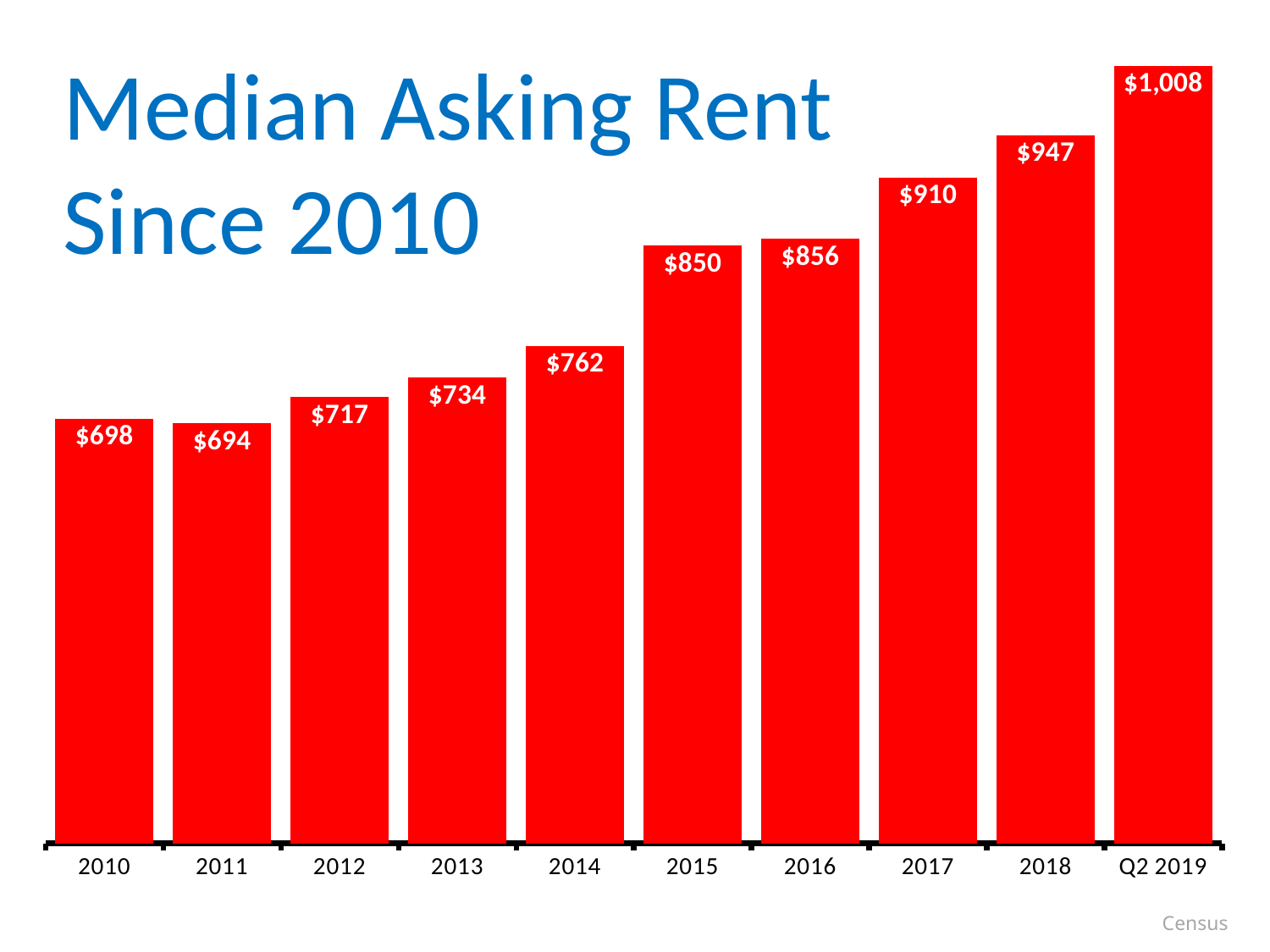
Which is larger, the median asking rent in 2013 or in 2014? 2014 What is the median asking rent shown for Q2 2019? $1,008 Which year has the lowest median asking rent? 2011 What is the median asking rent shown for 2015? $850 What is the difference between the median asking rent in 2018 and in 2017? $37 What is the median asking rent shown for 2010? $698 What is the difference between the median asking rent in Q2 2019 and in 2010? $310 Which period has the highest median asking rent? Q2 2019 Do the median asking rent values generally rise or fall from 2011 to Q2 2019? Rise How many periods are shown on the x axis? 10 What is the title of the chart? Median Asking Rent Since 2010 What kind of chart is shown on the slide? Bar chart